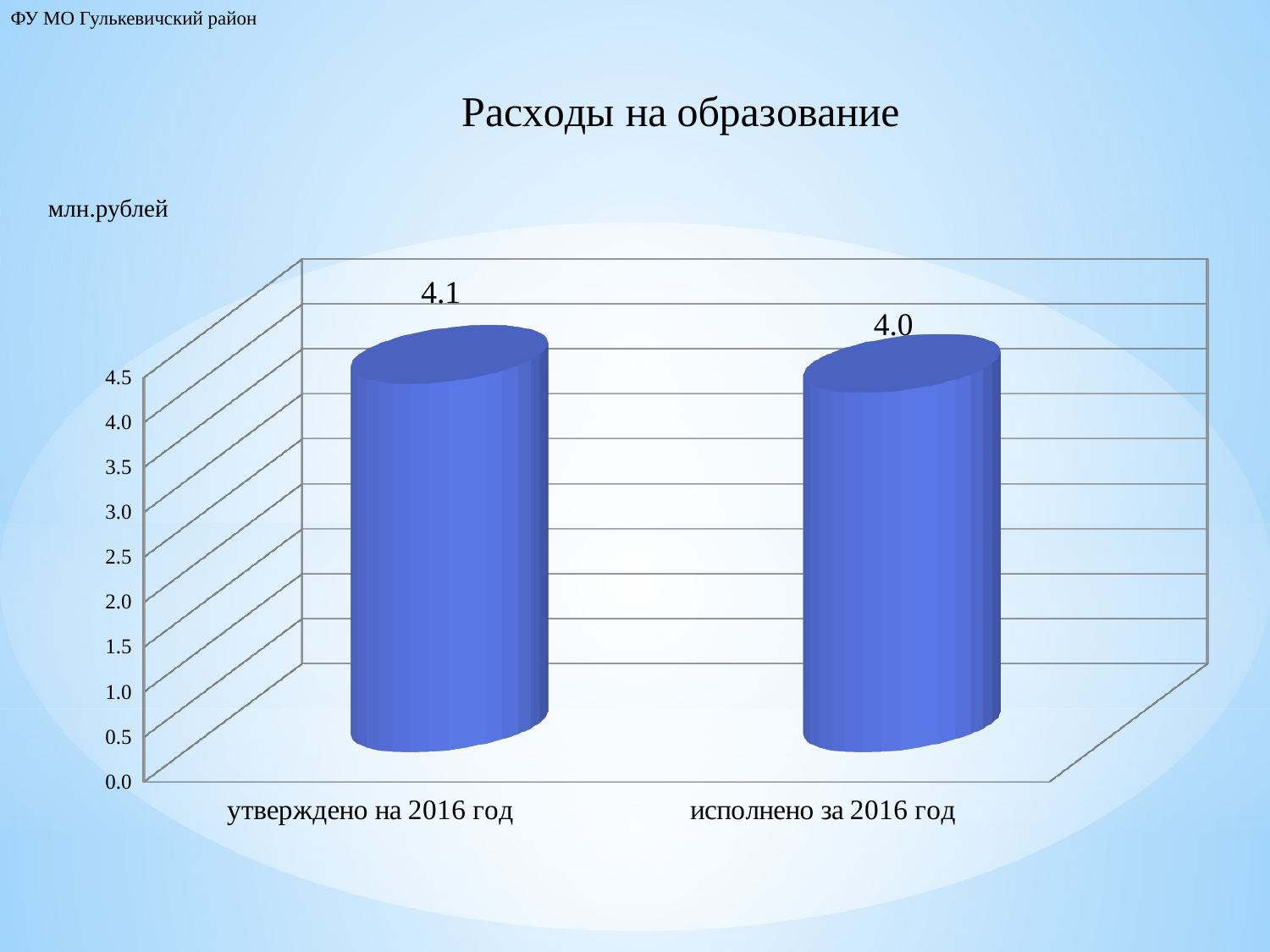
How many categories are shown on the chart? 2 What is the highest tick value shown on the vertical axis? 4.5 What unit is indicated for the values on the chart? млн.рублей Which category has the lower value? исполнено за 2016 год What is the title of the chart? Расходы на образование Is the value for "исполнено за 2016 год" greater or less than 3.0? greater What is the value for "исполнено за 2016 год"? 4.0 What kind of chart is shown on the slide? bar chart Which category has the higher value? утверждено на 2016 год Is the value for "утверждено на 2016 год" larger or smaller than the value for "исполнено за 2016 год"? larger What is the difference between the value for "утверждено на 2016 год" and the value for "исполнено за 2016 год"? 0.1 What is the value for "утверждено на 2016 год"? 4.1